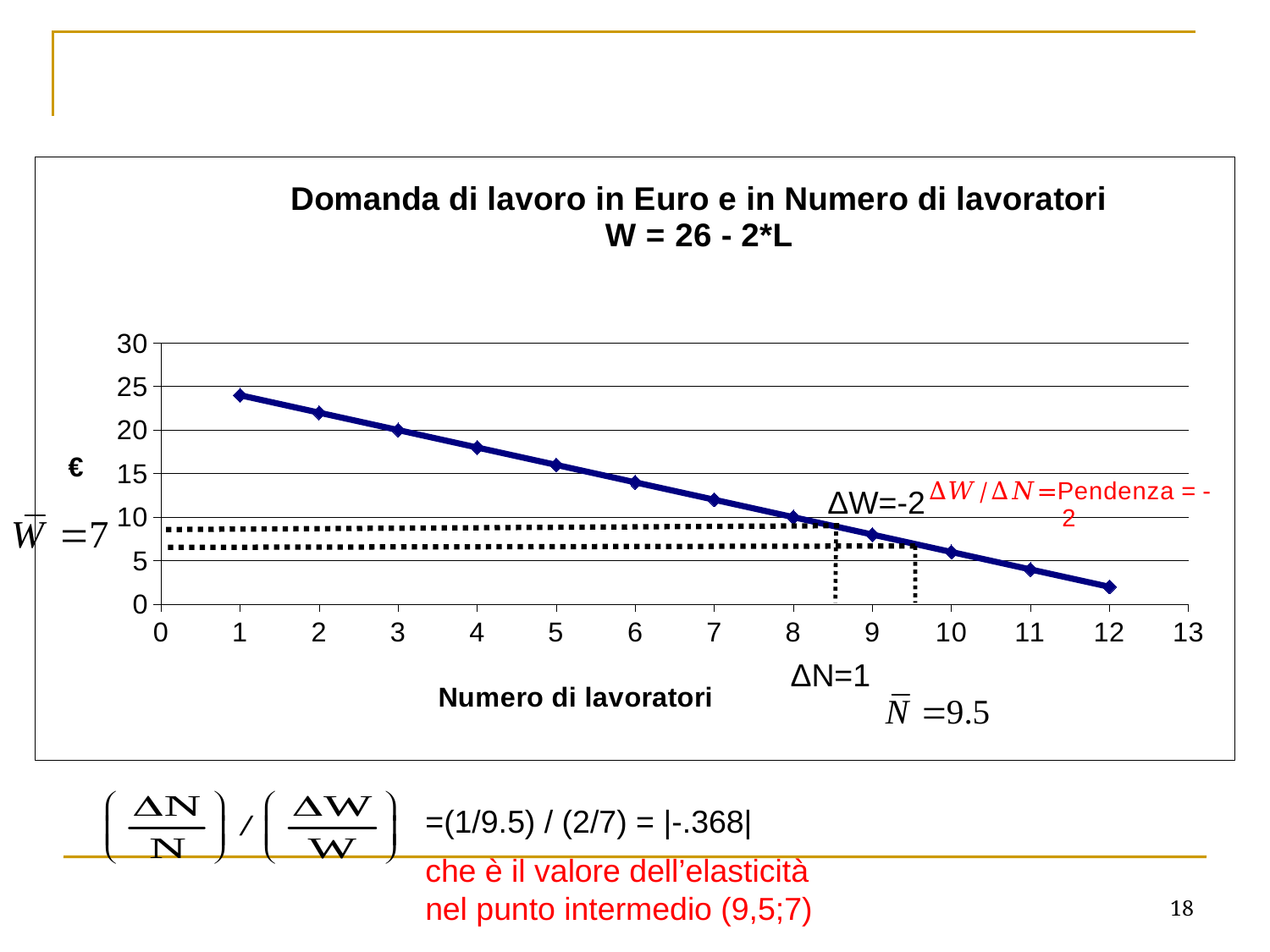
Is the value in € for 11 workers greater or less than 5? less At which number of workers is the value in € highest? 1 What is the value in € when the number of workers is 8? 10 What is the value in € when the number of workers is 3? 20 Is the value in € for 1 worker greater or less than 20? greater Do the values rise or fall as the number of workers increases along the x axis? fall At which number of workers is the value in € lowest? 12 What kind of chart is shown on the slide? line chart What is the label of the x axis? Numero di lavoratori Which has the larger value in €: 2 workers or 10 workers? 2 workers How many data points are plotted on the line? 12 What is the title of the chart? Domanda di lavoro in Euro e in Numero di lavoratori W = 26 - 2*L